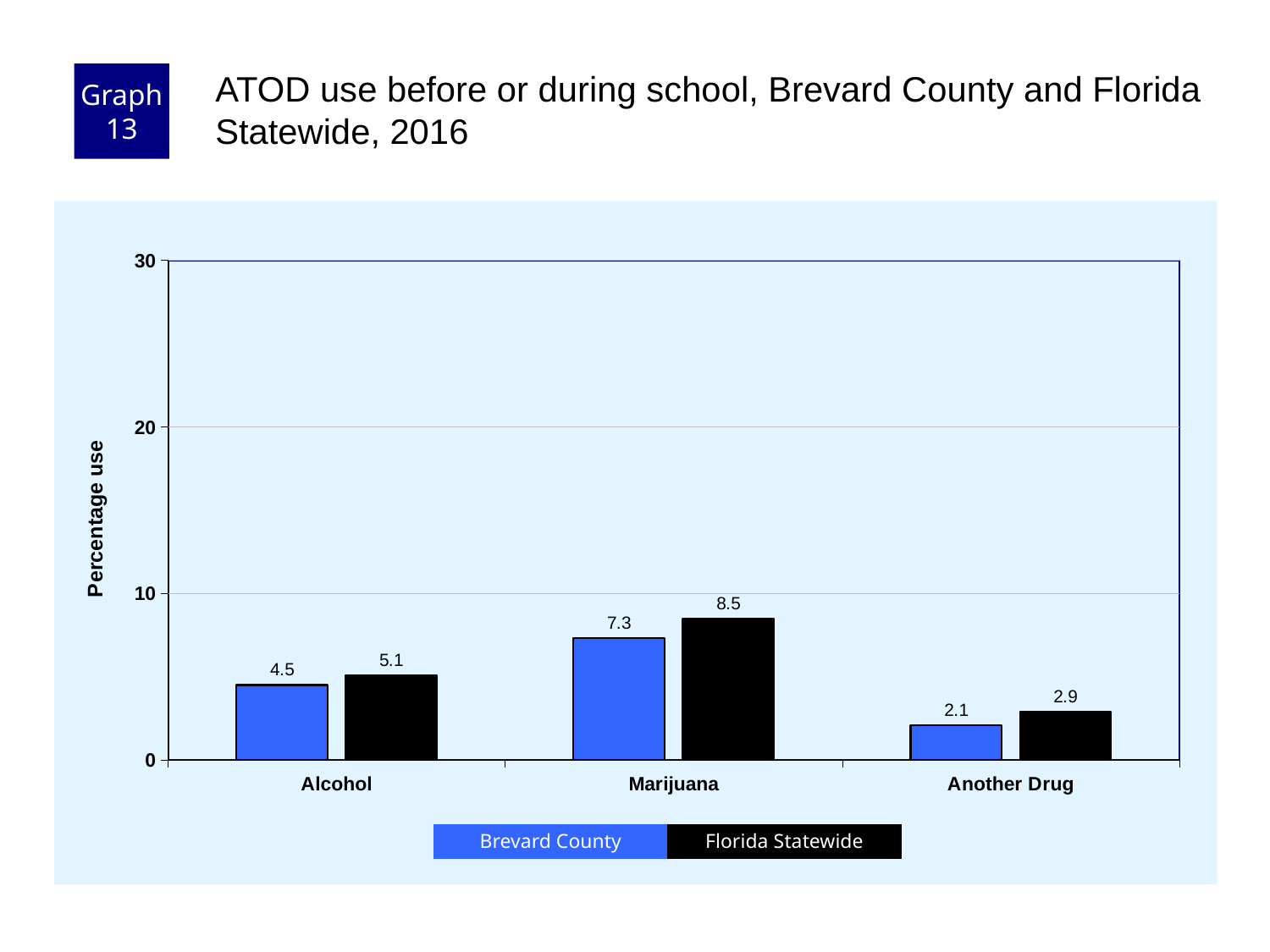
What is the Brevard County value for Another Drug? 2.1 What kind of chart is shown on the slide? bar chart What is the difference between the Florida Statewide and Brevard County values for Another Drug? 0.8 Which category has the lowest Brevard County value? Another Drug What is the difference between the Florida Statewide and Brevard County values for Marijuana? 1.2 Which is larger for Alcohol: the Brevard County value or the Florida Statewide value? Florida Statewide What is the Brevard County value for Alcohol? 4.5 Which category has the highest Florida Statewide value? Marijuana Is the Florida Statewide value for Marijuana greater or less than 10? less How many series does the legend list? 2 What is the Florida Statewide value for Marijuana? 8.5 How many categories are shown on the x axis? 3